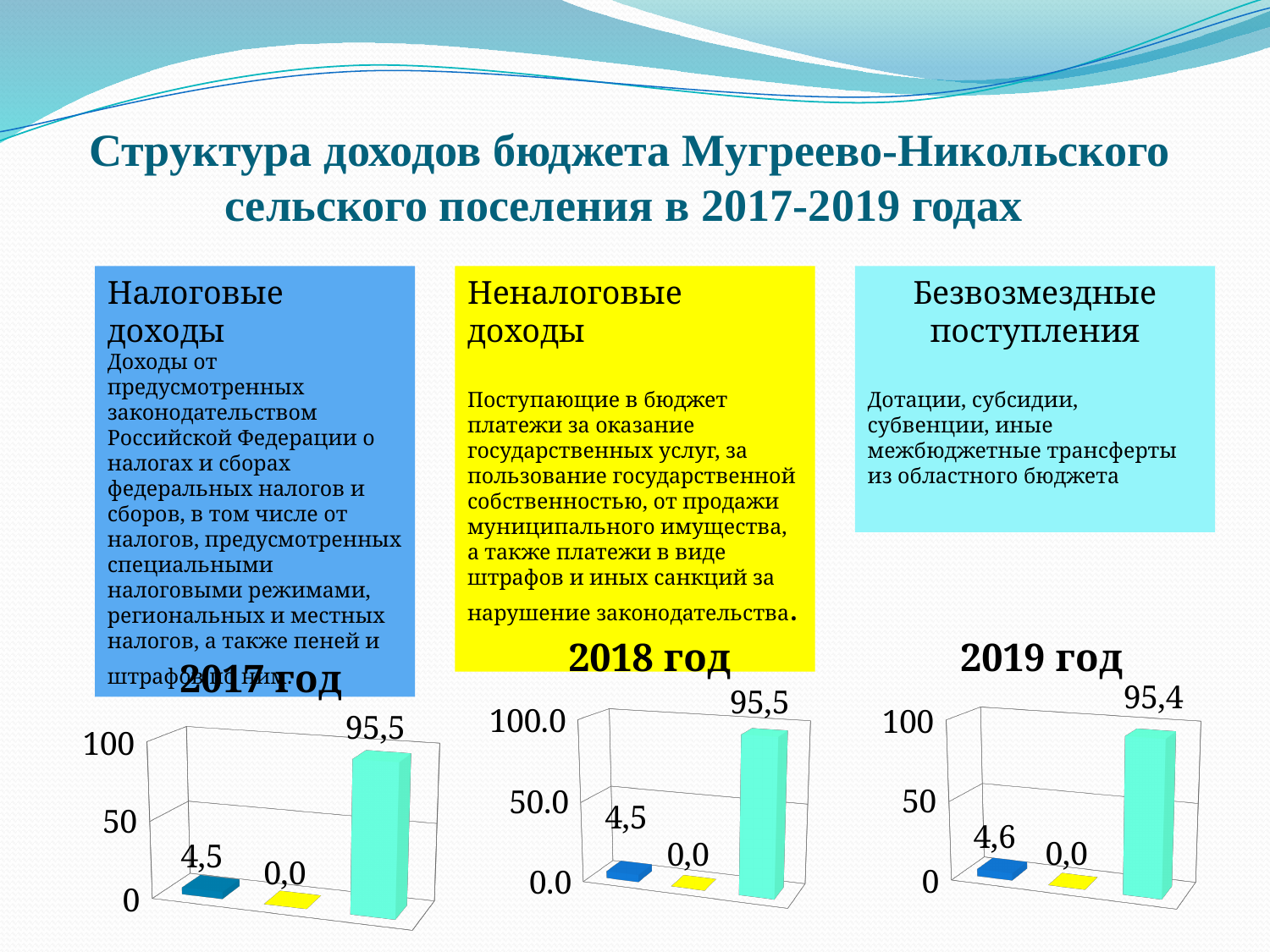
On the chart titled "2019 год", is the blue bar value greater or less than 50? less On the chart titled "2019 год", which bar colour has the lowest value? yellow How many bars are plotted on the chart titled "2018 год"? 3 On the chart titled "2017 год", what is the difference between the cyan bar value and the blue bar value? 91 How many charts are shown on the slide? 3 On the chart titled "2018 год", which bar colour has the highest value? cyan On the chart titled "2017 год", what value is labelled on the yellow bar? 0,0 On the chart titled "2017 год", what value is shown for the tallest (cyan) bar? 95,5 On the chart titled "2019 год", what value is labelled on the blue bar? 4,6 On the chart titled "2018 год", what value is labelled on the blue bar? 4,5 On the chart titled "2019 год", what value is labelled on the cyan bar? 95,4 What kind of chart is the chart titled "2017 год"? bar chart